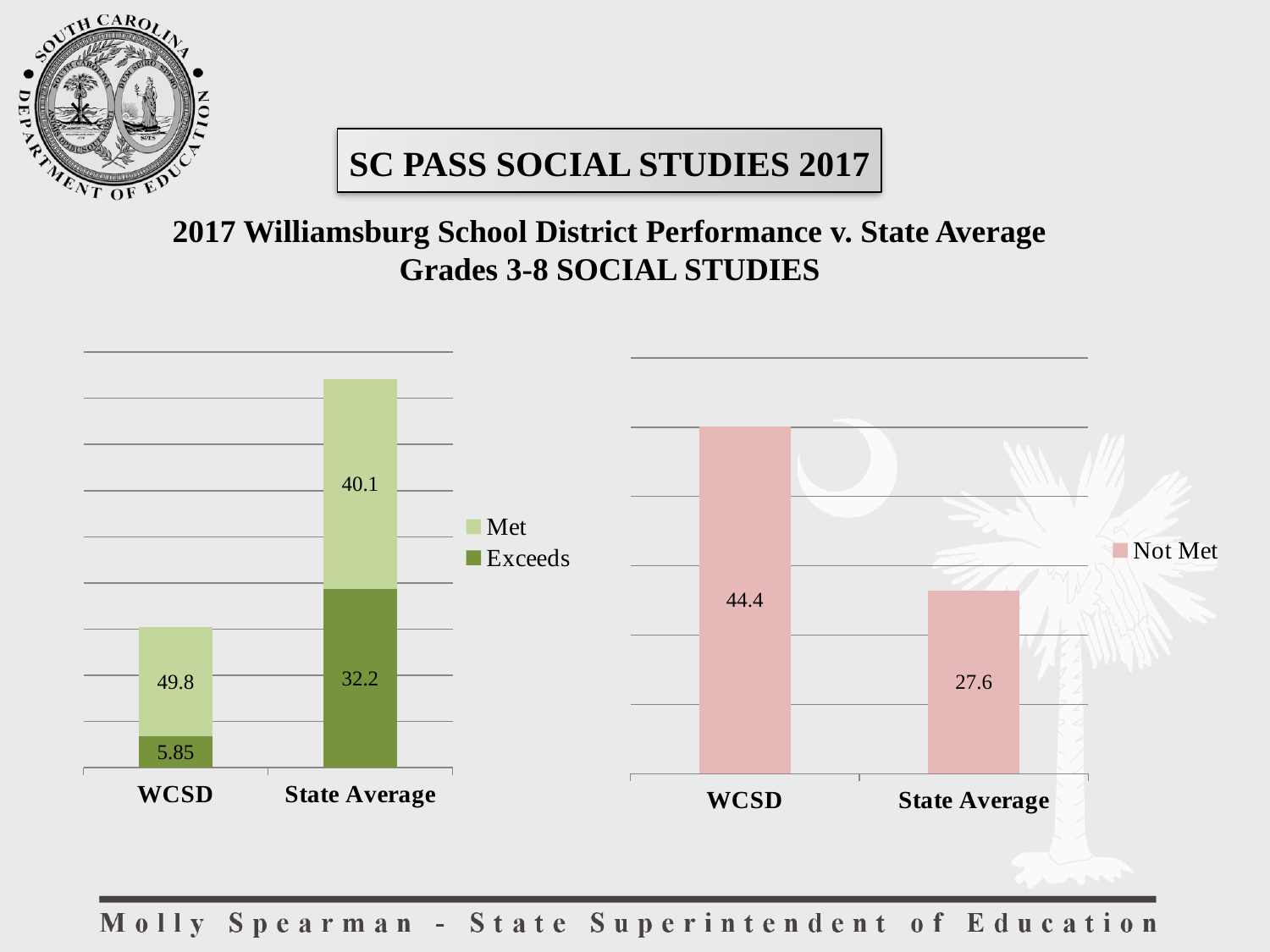
What is the legend entry of the right chart? Not Met What kind of chart is the right chart? Bar chart In the left chart, what is the Exceeds value for State Average? 32.2 In the right chart, which category has the lower Not Met value? State Average In the left chart, which is larger: the Met value for WCSD or the Met value for State Average? Met value for WCSD In the left chart, what is the total of the stacked bar for WCSD? 55.65 In the left chart, what is the Exceeds value for WCSD? 5.85 In the left chart, what is the total of the stacked bar for State Average? 72.3 In the right chart, what is the difference between the WCSD and State Average Not Met values? 16.8 In the left chart, what is the Met value for State Average? 40.1 How many series does the legend of the left chart list? 2 In the right chart, what is the Not Met value for WCSD? 44.4